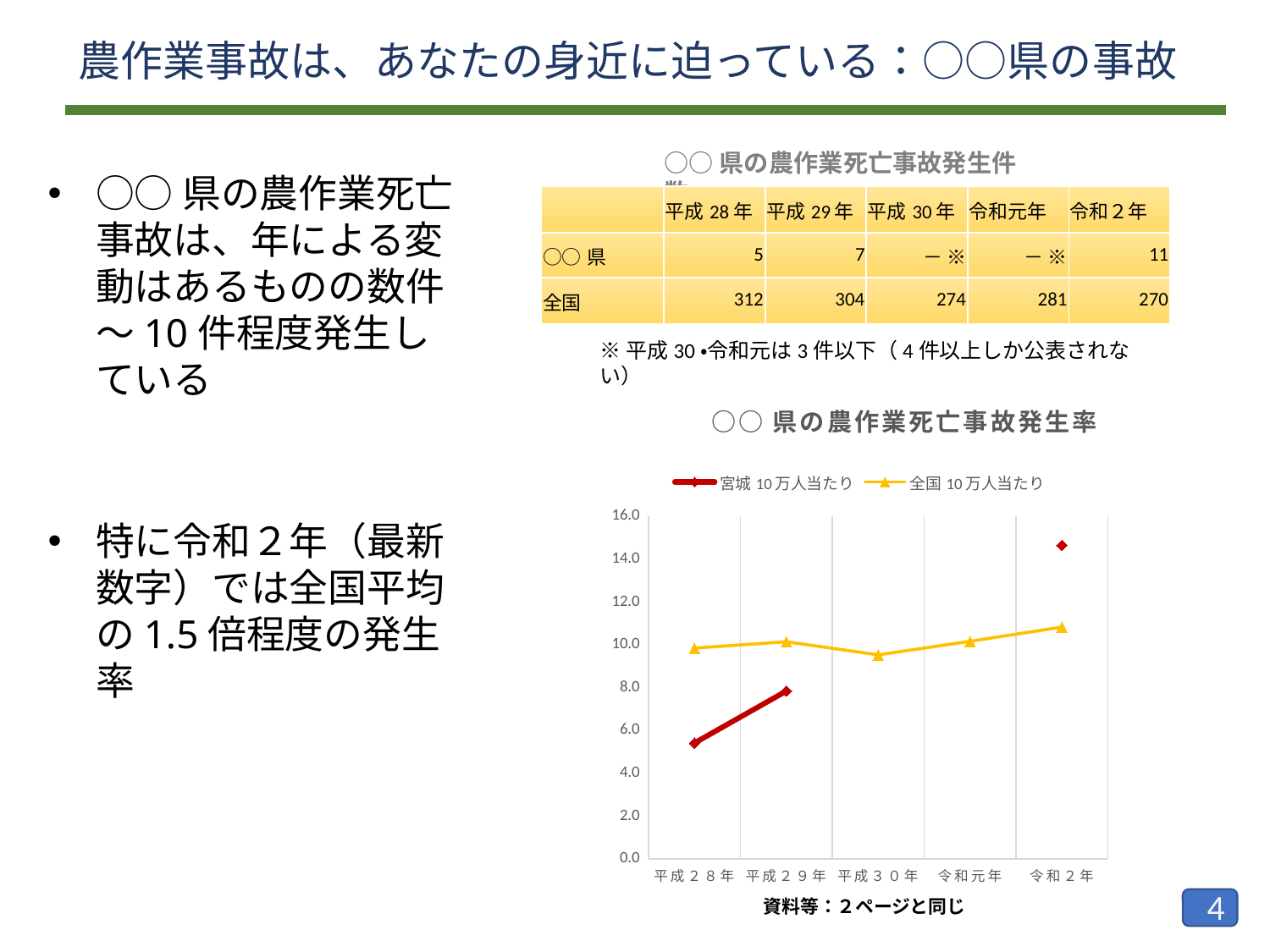
How many series does the legend of the ○○県の農作業死亡事故発生率 chart list? 2 In the ○○県の農作業死亡事故発生率 chart, which series has the larger value in 令和2年, 宮城 10万人当たり or 全国 10万人当たり? 宮城 10万人当たり In the ○○県の農作業死亡事故発生率 chart, is the value for 宮城 10万人当たり in 平成28年 greater or less than 6.0? less In the ○○県の農作業死亡事故発生率 chart, does the 宮城 10万人当たり series rise or fall from 平成28年 to 平成29年? rise In the ○○県の農作業死亡事故発生率 chart, is the value for 全国 10万人当たり in 平成30年 greater or less than 10.0? less In the ○○県の農作業死亡事故発生率 chart, is the value for 宮城 10万人当たり in 令和2年 greater or less than 14.0? greater How many year categories are shown on the x axis of the ○○県の農作業死亡事故発生率 chart? 5 In the ○○県の農作業死亡事故発生率 chart, which year has the highest value for 宮城 10万人当たり? 令和2年 What kind of chart is shown under the title ○○県の農作業死亡事故発生率? line chart In the ○○県の農作業死亡事故発生率 chart, which year has the lowest value for 全国 10万人当たり? 平成30年